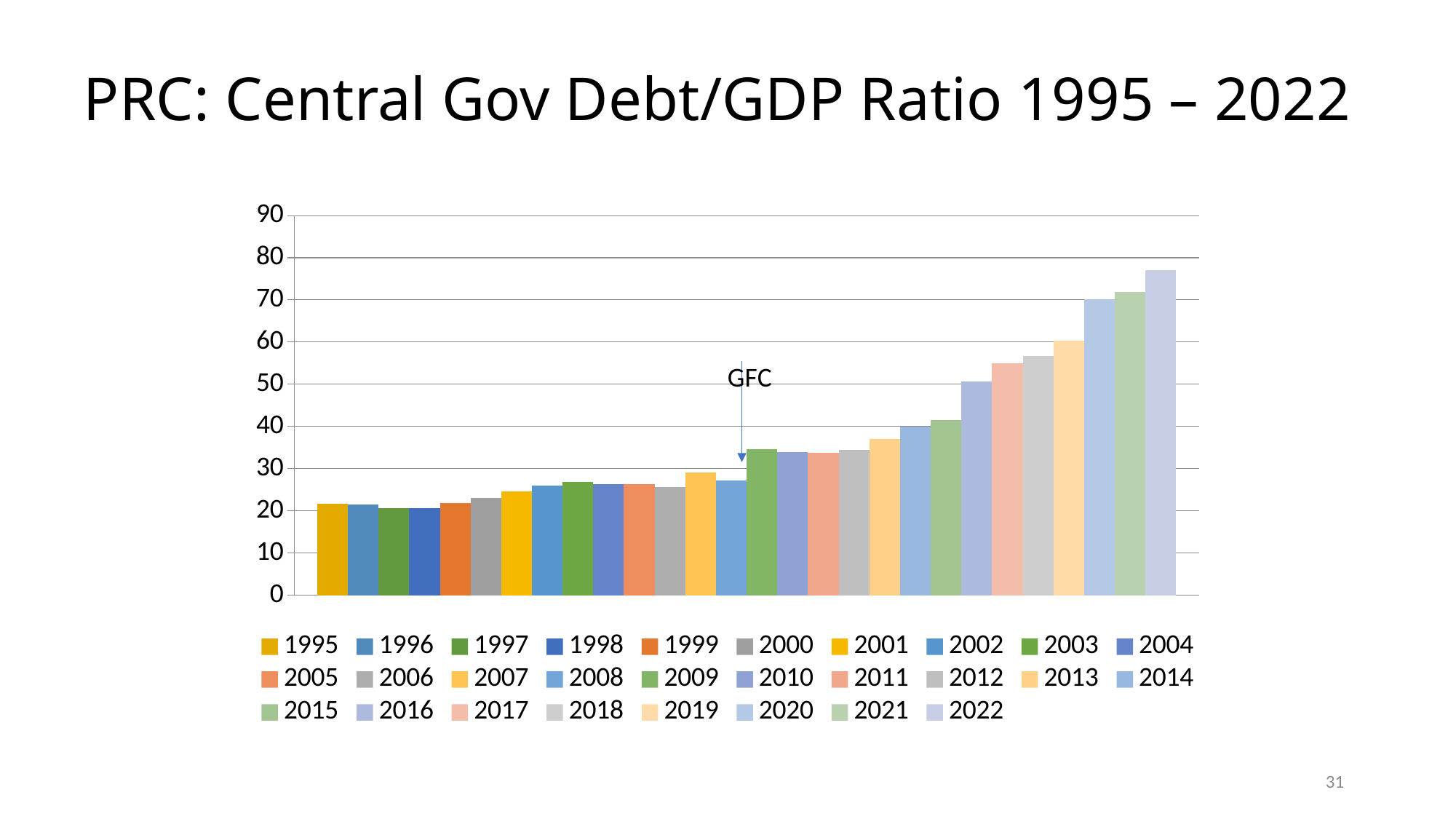
What is the title of the chart? PRC: Central Gov Debt/GDP Ratio 1995 – 2022 Do the values generally rise or fall from 1995 to 2022? rise How many bars (years) are plotted in the chart? 28 Which year has the highest Central Gov Debt/GDP ratio? 2022 Is the value for 1995 greater or less than 30? less Is the value for 2013 greater or less than 30? greater What kind of chart is shown on the slide? bar chart Is the value for 2022 greater or less than 70? greater What event label is annotated with an arrow on the chart? GFC Which is larger, the value for 2022 or the value for 1995? 2022 How many entries does the legend list? 28